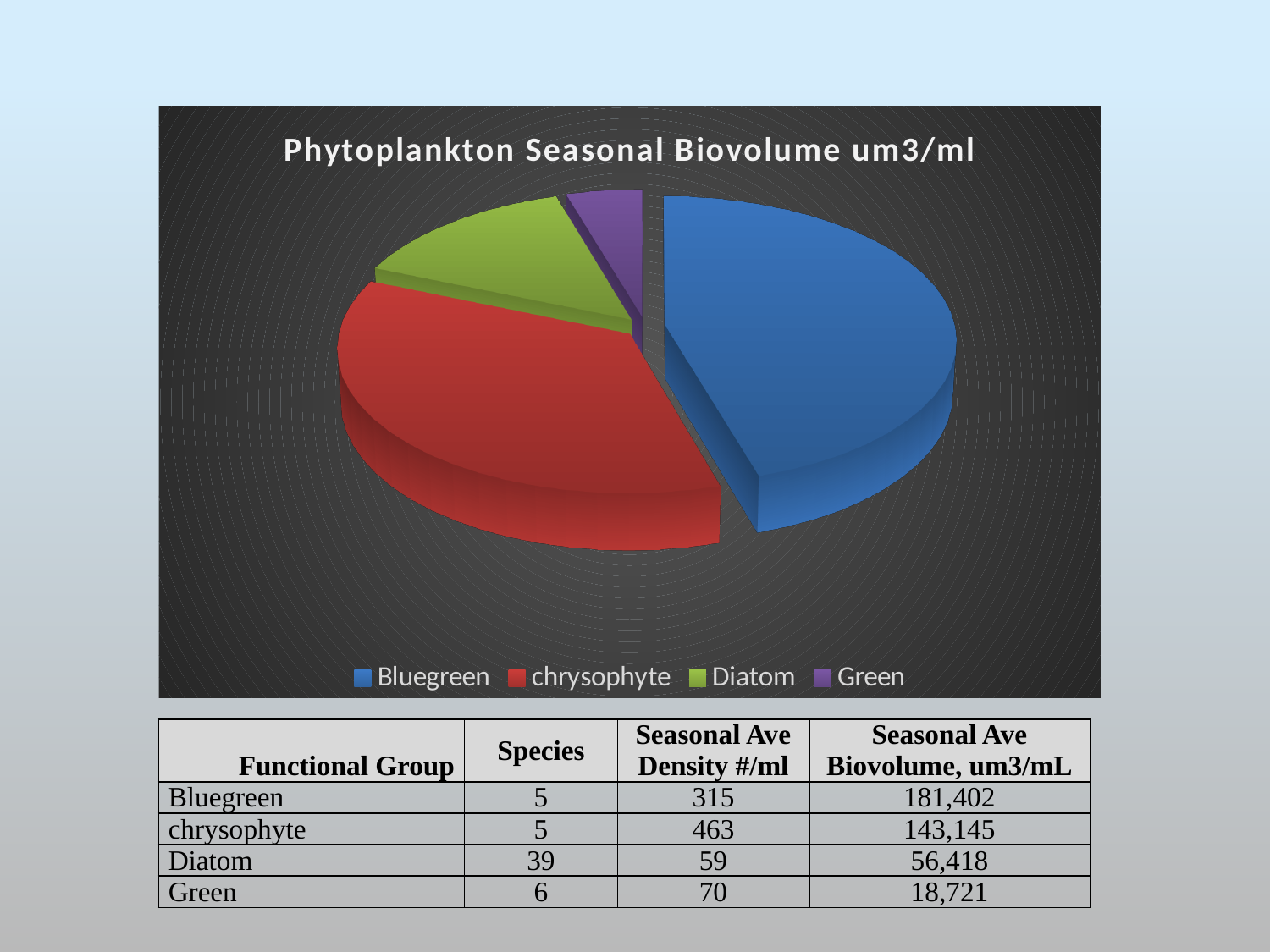
What colour is the chrysophyte slice in the pie chart? red Using the table values, what is the total seasonal average biovolume across all four functional groups? 399,686 Which slice is larger, chrysophyte or Diatom? chrysophyte What kind of chart is shown on the slide? pie chart How many entries does the chart legend list? 4 Which functional group has the smallest slice of the pie chart? Green According to the table, what is the seasonal average biovolume for Bluegreen? 181,402 According to the table, what is the seasonal average biovolume for Diatom? 56,418 What is the title of the chart? Phytoplankton Seasonal Biovolume um3/ml Which functional group has the largest slice of the pie chart? Bluegreen Using the table values, what is the difference in seasonal average biovolume between Bluegreen and chrysophyte? 38,257 How many slices does the pie chart have? 4